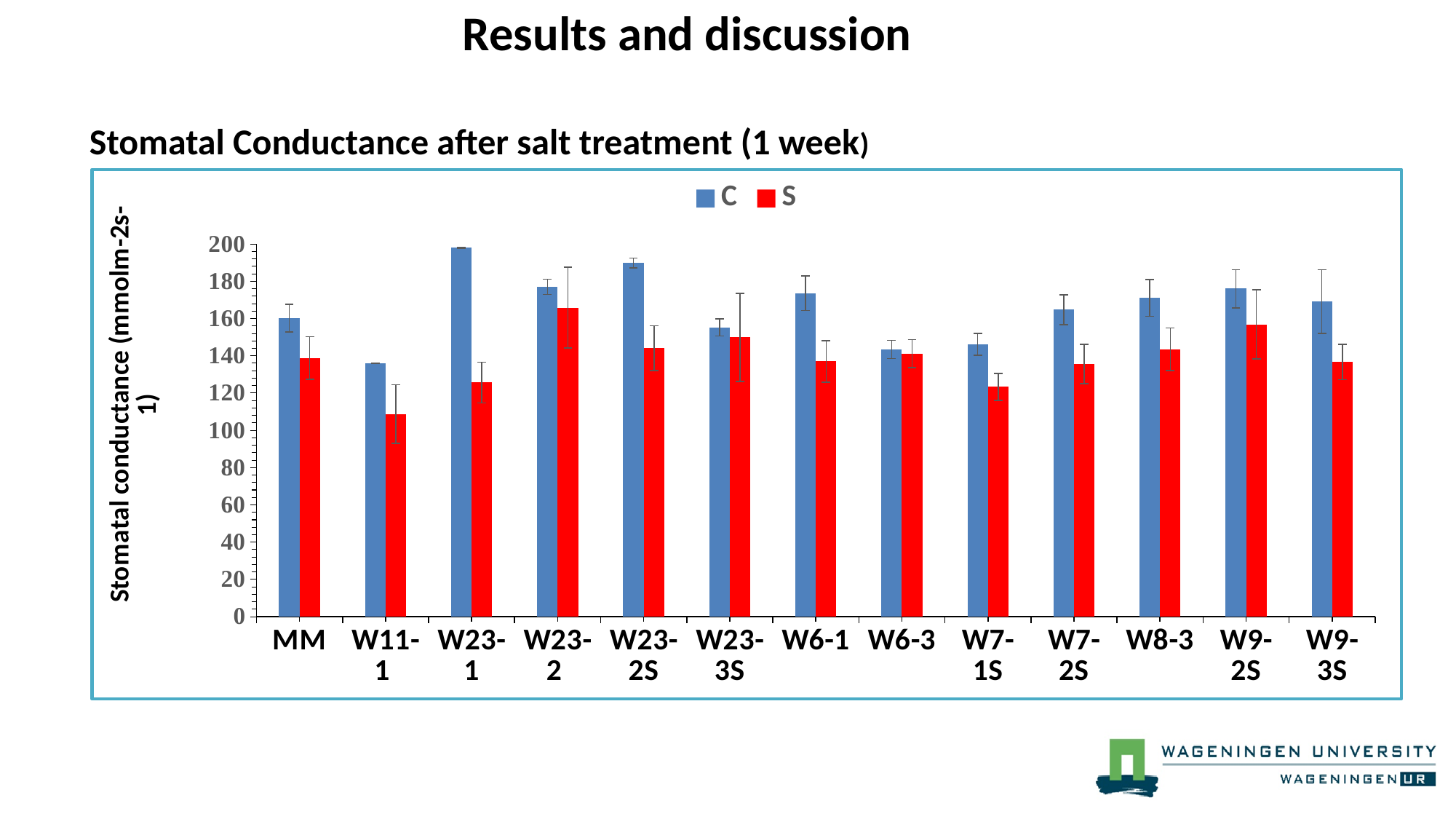
Is the value for series S at W7-1S greater or less than 140? less Is the value for series S at W11-1 greater or less than 120? less Is the value for series C at W23-1 greater or less than 180? greater Which category has the lowest value for series C? W11-1 What kind of chart is shown on the slide? bar chart How many categories are shown on the x axis? 13 For W23-1, which series has the larger value, C or S? C Which category has the lowest value for series S? W11-1 How many series does the legend list? 2 Which colour represents series S in the legend? red Which category has the highest value for series C? W23-1